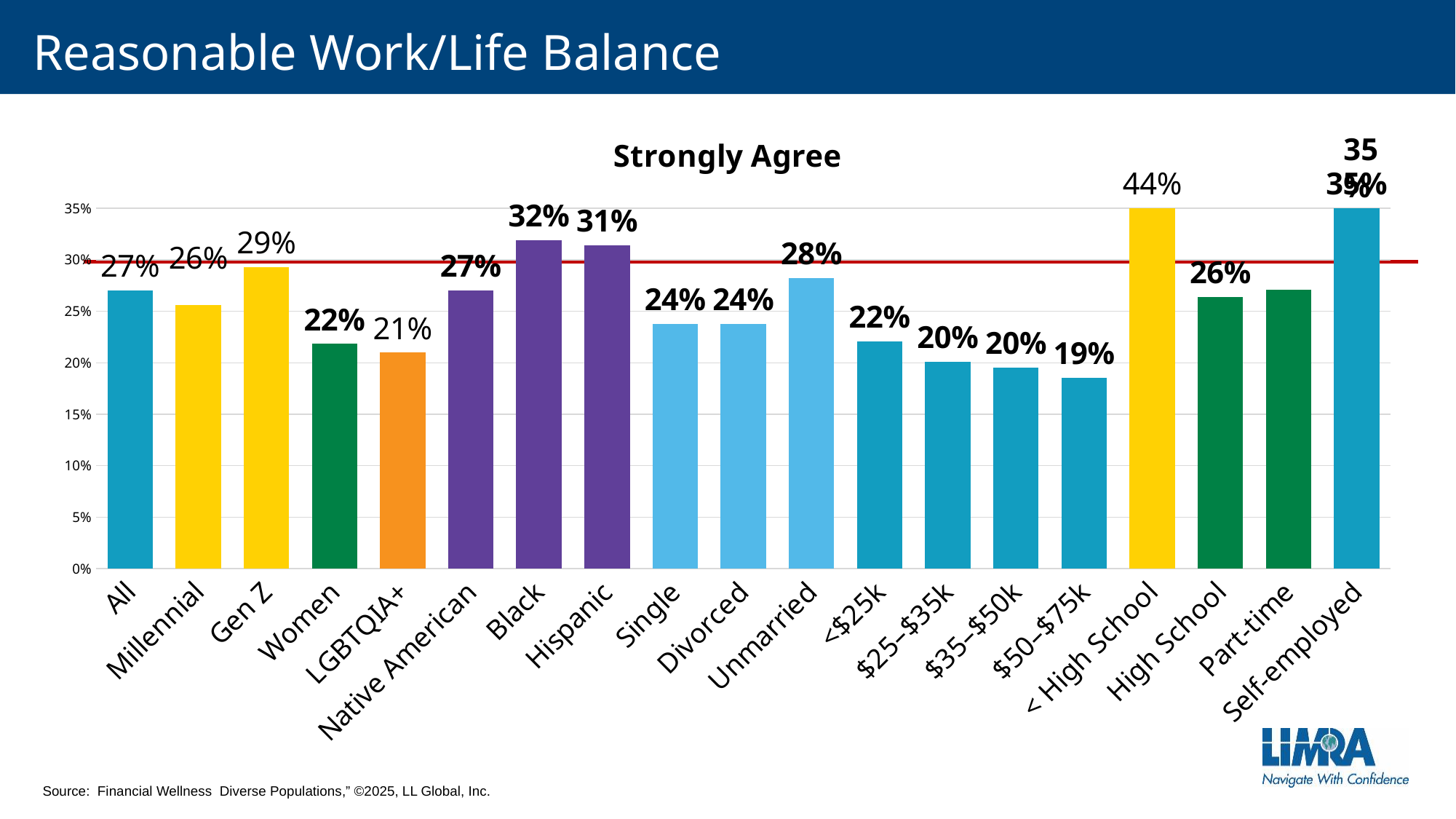
What is the value for Black in the Strongly Agree chart? 32% What is the value for Gen Z in the Strongly Agree chart? 29% Which category has the lowest value in the Strongly Agree chart? $50–$75k Is the value for Part-time greater or less than 30%? less How many categories are shown in the Strongly Agree chart? 19 What is the value for Unmarried in the Strongly Agree chart? 28% What is the difference between the values for Black and Women? 10% What kind of chart is shown on the slide? bar chart What is the value for LGBTQIA+ in the Strongly Agree chart? 21% Which is larger, the value for Hispanic or the value for Native American? Hispanic Which category has the highest value in the Strongly Agree chart? < High School What is the difference between the values for < High School and $50–$75k? 25%